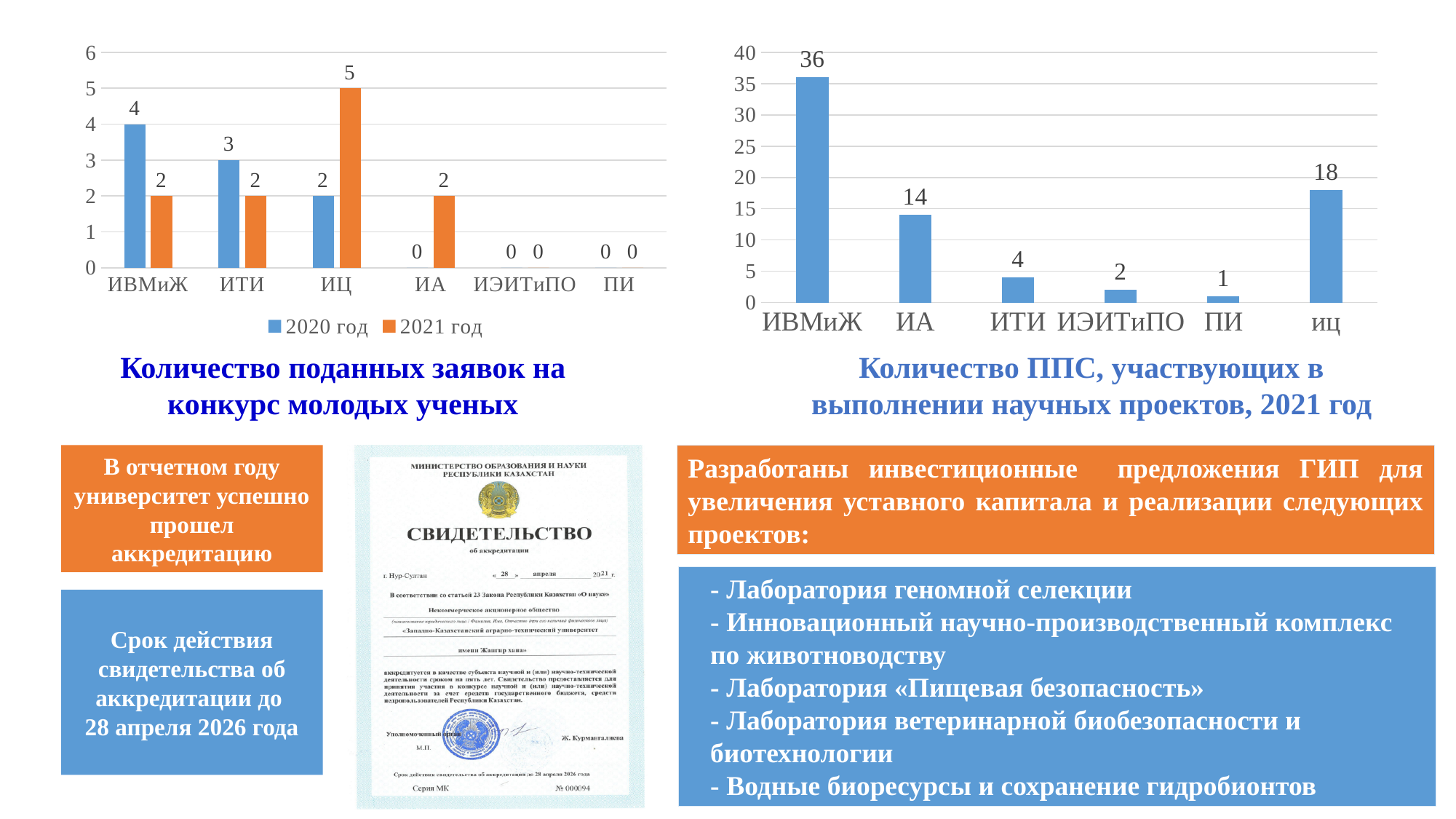
In the right chart (Количество ППС, участвующих в выполнении научных проектов, 2021 год), which is larger, the value for ИТИ or the value for ИЭИТиПО? ИТИ In the left chart (Количество поданных заявок на конкурс молодых ученых), what is the value for ИВМиЖ in 2020 год? 4 In the left chart (Количество поданных заявок на конкурс молодых ученых), what is the difference between the 2020 год and 2021 год values for ИТИ? 1 In the right chart (Количество ППС, участвующих в выполнении научных проектов, 2021 год), what is the value for ИА? 14 In the right chart (Количество ППС, участвующих в выполнении научных проектов, 2021 год), which category has the lowest value? ПИ In the right chart (Количество ППС, участвующих в выполнении научных проектов, 2021 год), what is the difference between the values for ИВМиЖ and ИЦ? 18 In the left chart (Количество поданных заявок на конкурс молодых ученых), how many categories are shown on the x axis? 6 In the left chart (Количество поданных заявок на конкурс молодых ученых), how many series does the legend list? 2 What kind of chart is the right chart (Количество ППС, участвующих в выполнении научных проектов, 2021 год)? Bar chart In the left chart (Количество поданных заявок на конкурс молодых ученых), what is the value for ИЦ in 2021 год? 5 In the right chart (Количество ППС, участвующих в выполнении научных проектов, 2021 год), which category has the highest value? ИВМиЖ In the left chart (Количество поданных заявок на конкурс молодых ученых), which category has the highest value for 2021 год? ИЦ